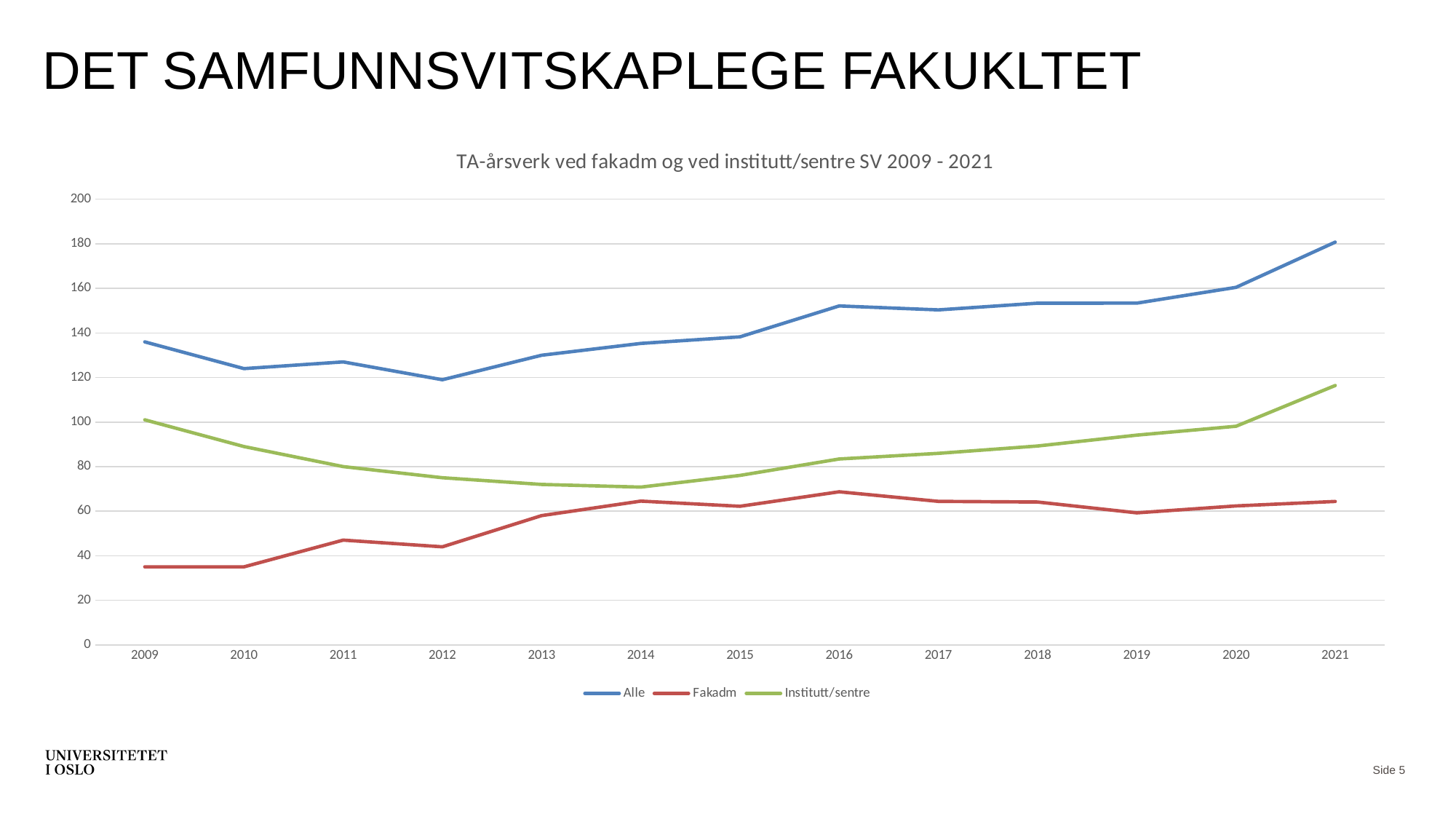
Is the value for Fakadm in 2009 greater or less than 40? less In which year is the Institutt/sentre series at its highest? 2021 Does the Institutt/sentre series rise or fall from 2009 to 2014? fall In which year is the Fakadm series at its highest? 2016 What is the title of the chart? TA-årsverk ved fakadm og ved institutt/sentre SV 2009 - 2021 Is the value for Alle in 2021 greater or less than 160? greater How many series does the legend list? 3 How many years are plotted along the x axis? 13 Which is larger in 2021, Fakadm or Institutt/sentre? Institutt/sentre In which year is the Alle series at its lowest? 2012 What kind of chart is shown on the slide? line chart In which year is the Alle series at its highest? 2021